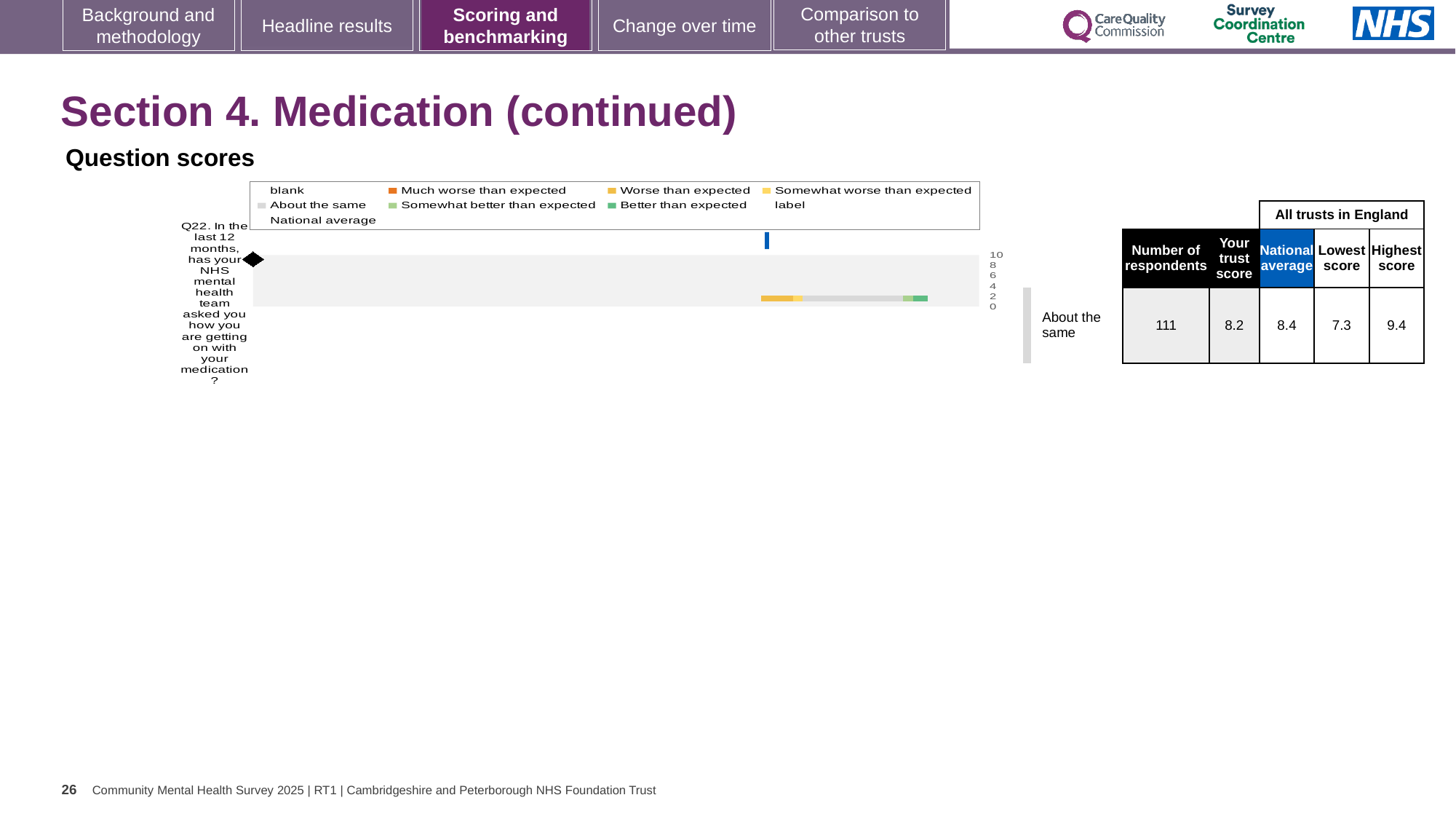
What is the trust's score for Q22? 8.2 What is the lowest score among all trusts in England for Q22? 7.3 How many entries does the chart legend list? 9 Which question is plotted in the chart? Q22. In the last 12 months, has your NHS mental health team asked you how you are getting on with your medication? How many survey questions are plotted in the chart? 1 How is the trust's Q22 score categorised relative to expectations? About the same What is the difference between the highest and lowest scores for Q22? 2.1 How many respondents answered Q22? 111 What is the national average score for Q22? 8.4 What is the highest score among all trusts in England for Q22? 9.4 What kind of chart is shown under 'Question scores'? bar chart Which is larger for Q22, the trust's score or the national average? national average